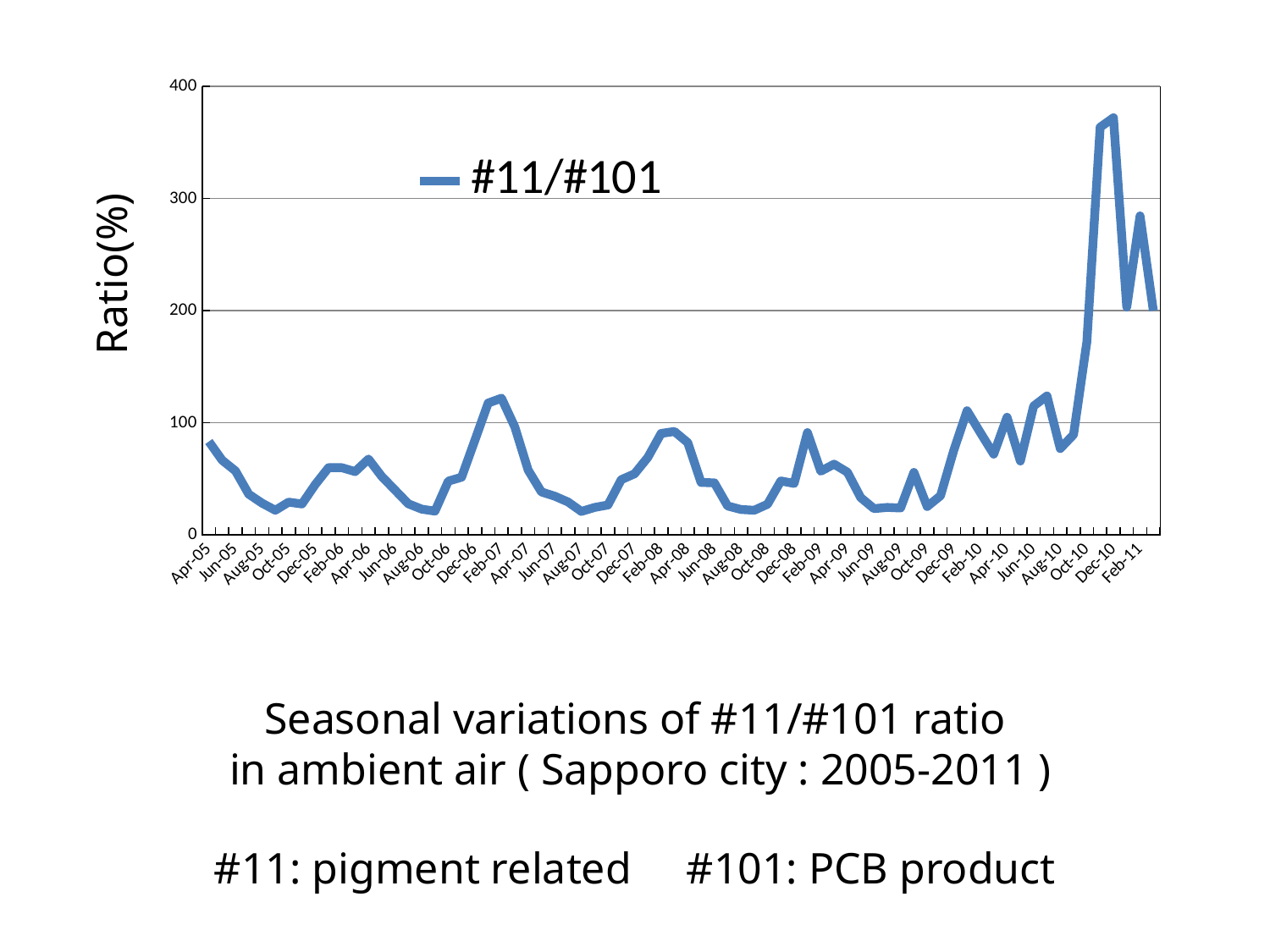
What is the name of the series shown in the legend? #11/#101 Is the value for Apr-05 greater or less than 100? less Is the value for Feb-07 greater or less than 100? greater Is the ratio at the end of the period (early 2011) higher or lower than at the start (Apr-05)? higher Is the value for Dec-10 greater or less than 300? greater How many series does the legend list? 1 Which is larger, the value for Dec-10 or the value for Apr-05? Dec-10 What is the label of the vertical axis? Ratio(%) What kind of chart is shown on the slide? line chart